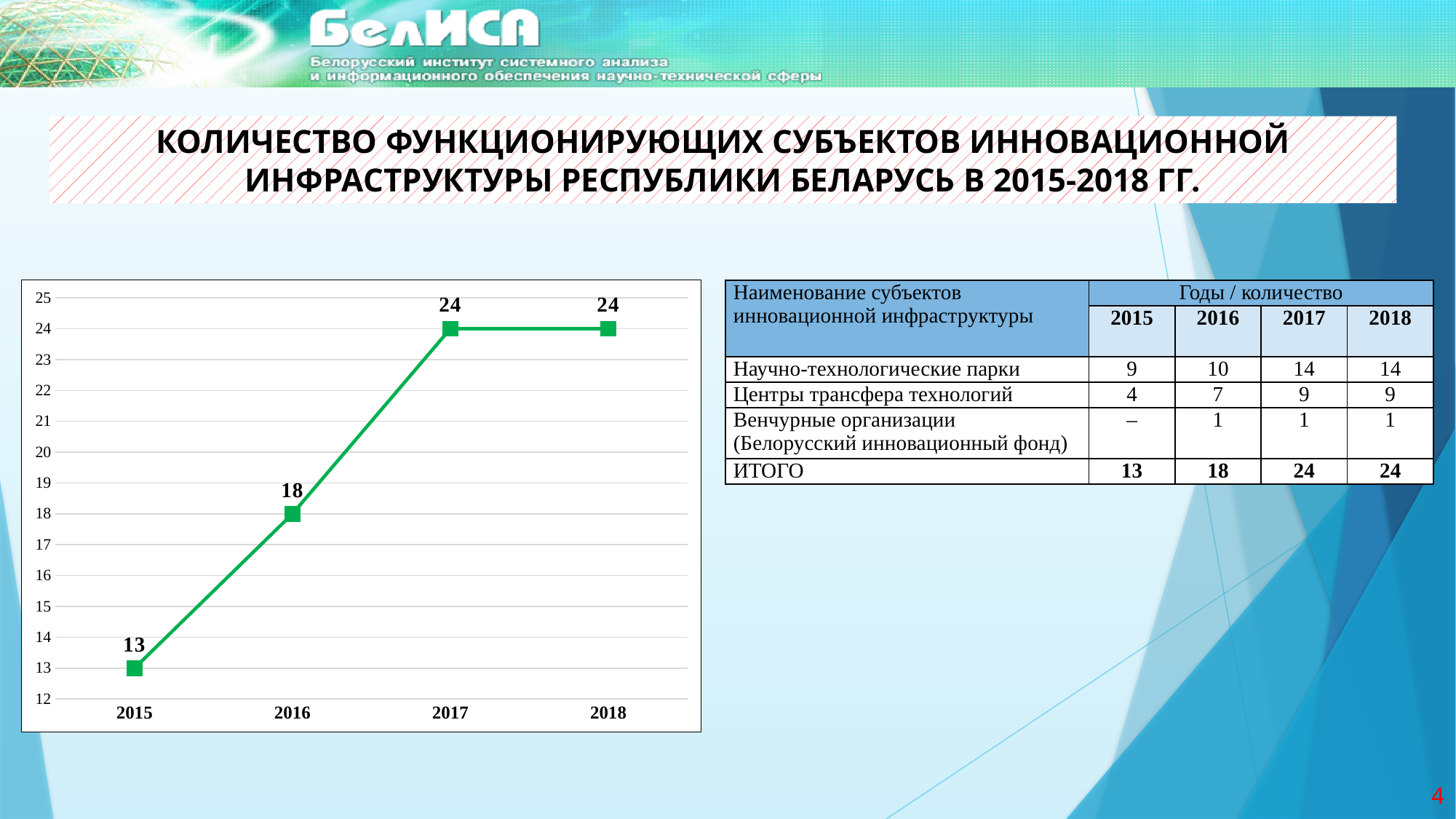
What is the value for 2018 in the line chart? 24 What is the difference between the values for 2016 and 2015 in the line chart? 5 What is the value for 2017 in the line chart? 24 What kind of chart is shown on the slide? line chart What is the difference between the values for 2017 and 2015 in the line chart? 11 How many years are plotted on the x axis of the line chart? 4 What is the value for 2015 in the line chart? 13 Is the value for 2016 in the line chart greater or less than 20? less Which year has the lowest value in the line chart? 2015 Which is larger in the line chart, the value for 2016 or the value for 2017? 2017 Do the values in the line chart rise or fall from 2015 to 2017? rise What is the value for 2016 in the line chart? 18